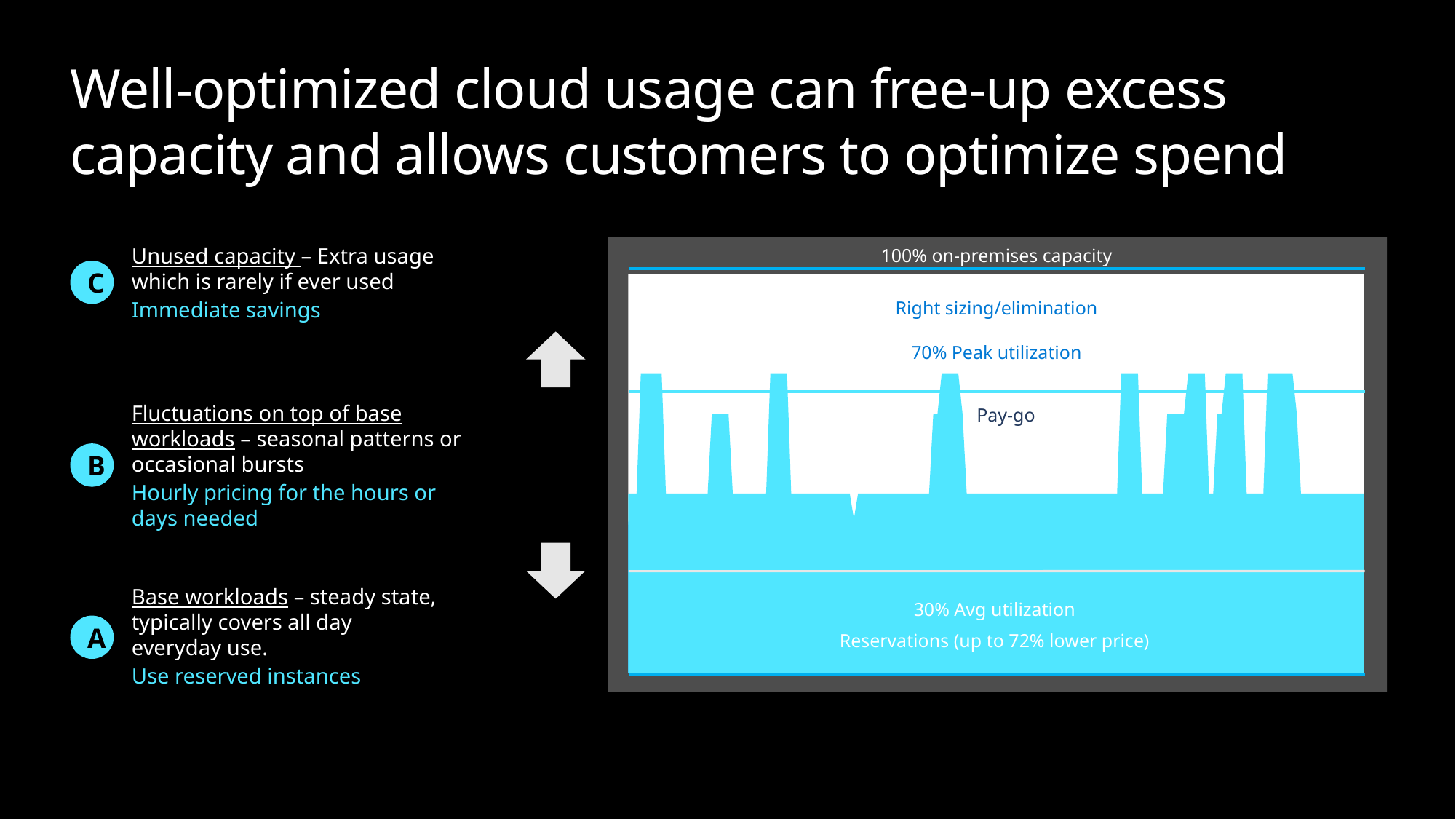
What is the difference between the 100% on-premises capacity line and the peak utilization level? 30% What percentage is labelled as the average utilization level in the chart? 30% What kind of chart is shown on the slide? Area chart Which is higher in the chart, the peak utilization level or the average utilization level? Peak utilization Which pricing approach is labelled in the region between the average utilization line and the peak utilization line? Pay-go Up to what percentage lower price is stated for reservations in the chart? 72% What percentage is labelled as the peak utilization level in the chart? 70% How many labelled horizontal level lines does the chart show? 3 What does the top horizontal line of the chart represent? 100% on-premises capacity Which action is labelled in the region between the peak utilization line and the 100% on-premises capacity line? Right sizing/elimination What is the difference between the peak utilization level and the average utilization level shown in the chart? 40%